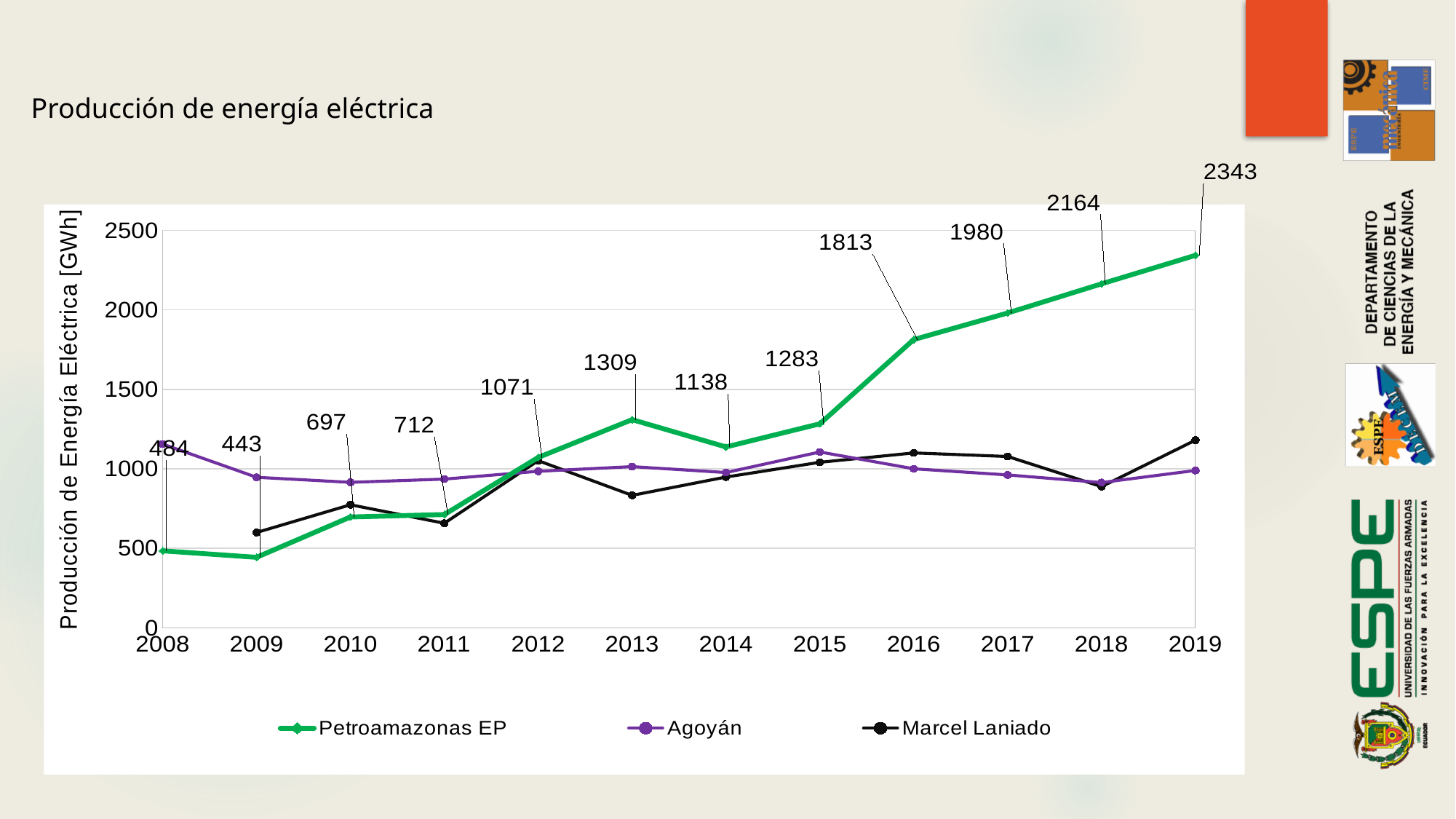
Is the value for Marcel Laniado in 2013 greater or less than 1000? less What is the value for Petroamazonas EP in 2013? 1309 Does the Petroamazonas EP value rise or fall from 2015 to 2019? rise What kind of chart is shown on the slide? line chart Is the value for Agoyán in 2008 greater or less than 1000? greater How many years are shown on the x axis? 12 How many series does the legend list? 3 In which year is the Petroamazonas EP value highest? 2019 In which year is the Petroamazonas EP value lowest? 2009 Which is larger for Petroamazonas EP, the value for 2014 or the value for 2015? 2015 What is the value for Petroamazonas EP in 2019? 2343 What is the difference between the Petroamazonas EP values for 2019 and 2018? 179